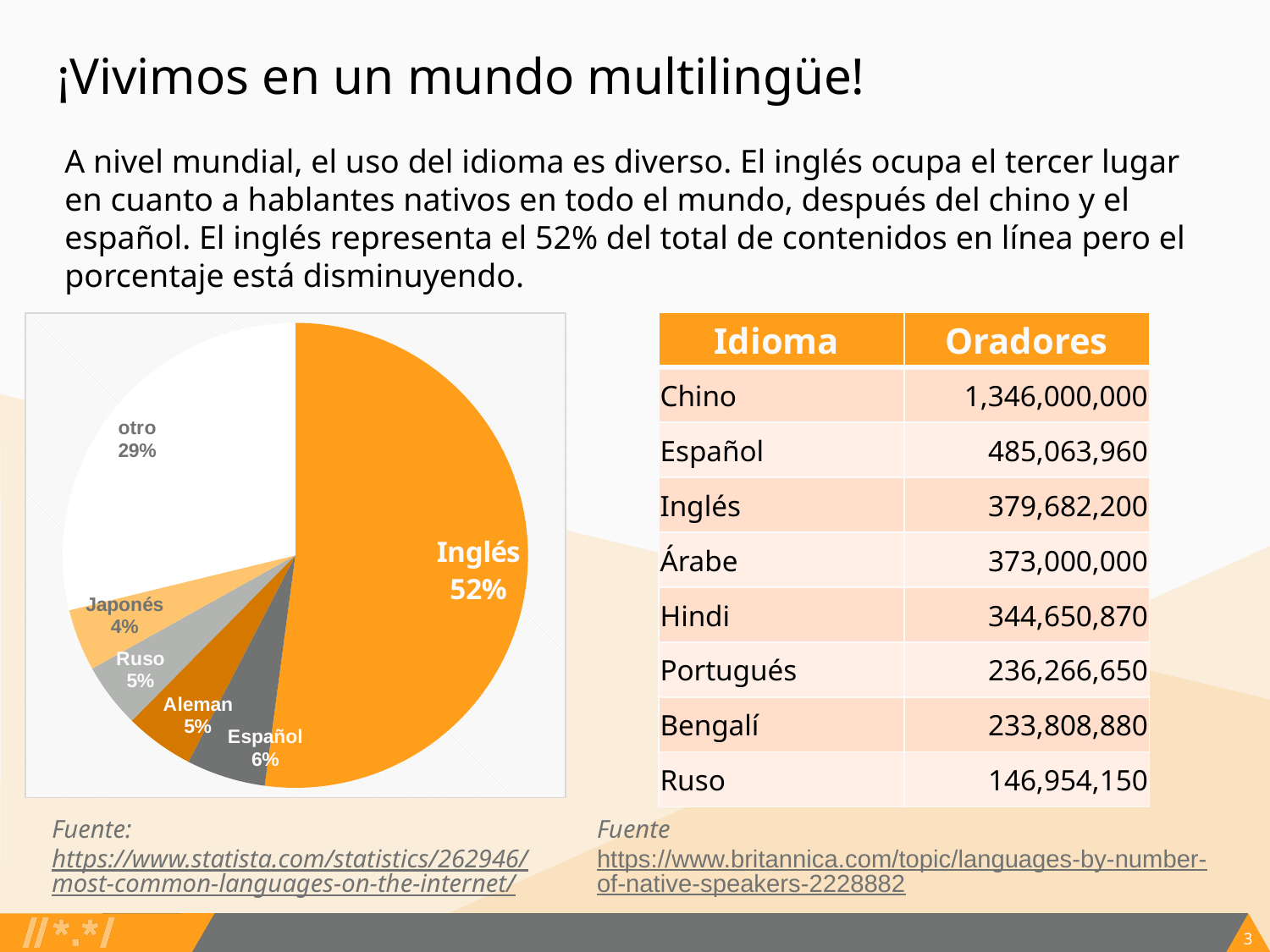
In the pie chart, what share does Inglés have? 52% In the pie chart, which is larger, Español or Ruso? Español What kind of chart is shown on the left of the slide? pie chart Which slice of the pie chart is the smallest? Japonés In the pie chart, what is the value for Español? 6% In the pie chart, what is the difference between the Inglés share and the otro share? 23% In the pie chart, what share does otro have? 29% In the pie chart, what is the value for Aleman? 5% Which slice of the pie chart is the largest? Inglés In the pie chart, what is the value for Japonés? 4% How many slices does the pie chart have? 6 In the pie chart, what is the combined share of Ruso and Aleman? 10%